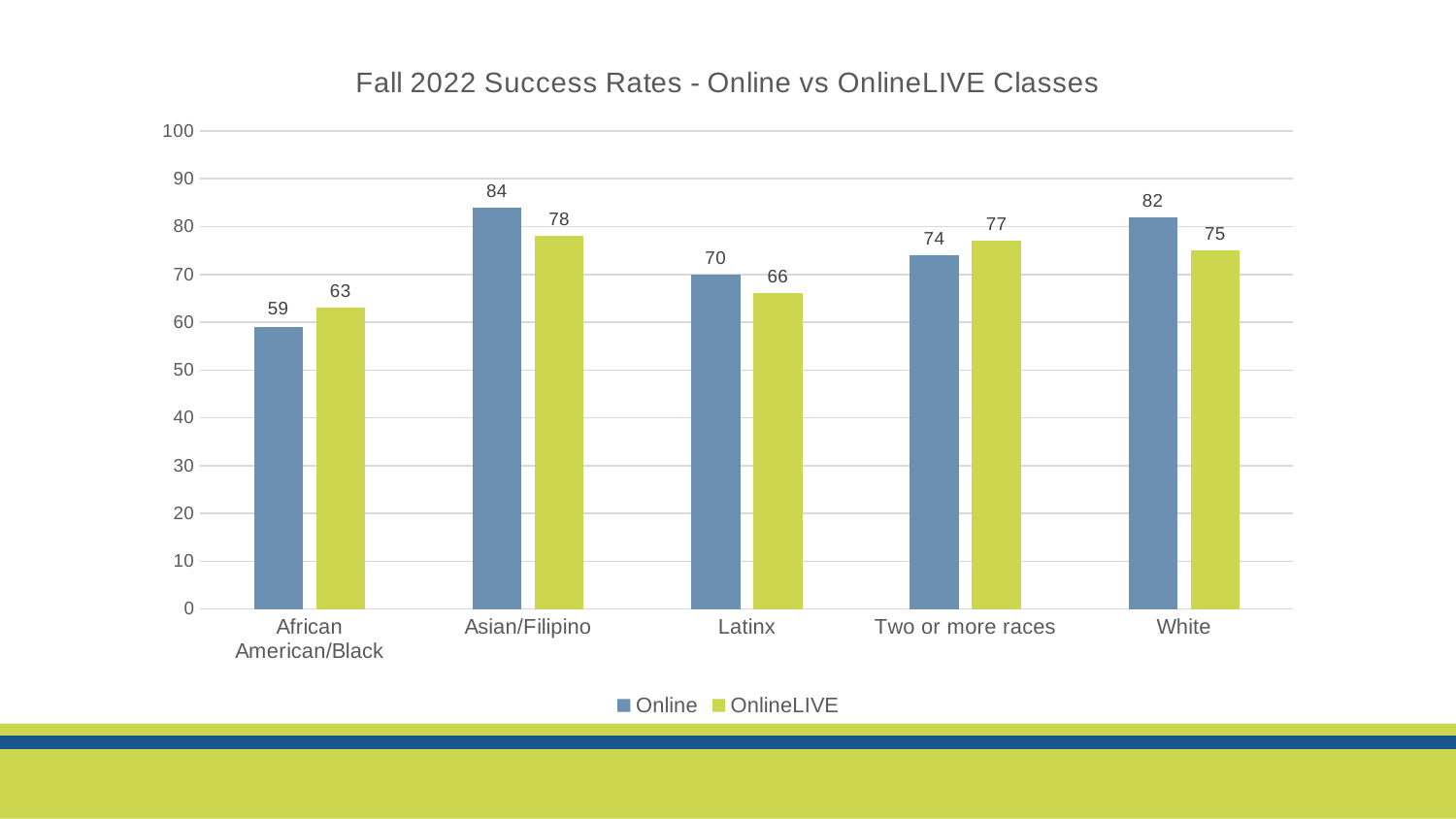
How many series does the legend list? 2 What is the title of the chart? Fall 2022 Success Rates - Online vs OnlineLIVE Classes What kind of chart is shown on the slide? Bar chart What is the difference between the Online and OnlineLIVE values for White? 7 What is the OnlineLIVE success rate for African American/Black students? 63 Which category has the lowest OnlineLIVE success rate? African American/Black For Latinx, which is larger, the Online or the OnlineLIVE value? Online Which category has the highest Online success rate? Asian/Filipino What is the Online success rate for Asian/Filipino students? 84 How many categories are shown on the x axis? 5 What is the OnlineLIVE value for Two or more races? 77 Which colour represents the OnlineLIVE series? Yellow-green